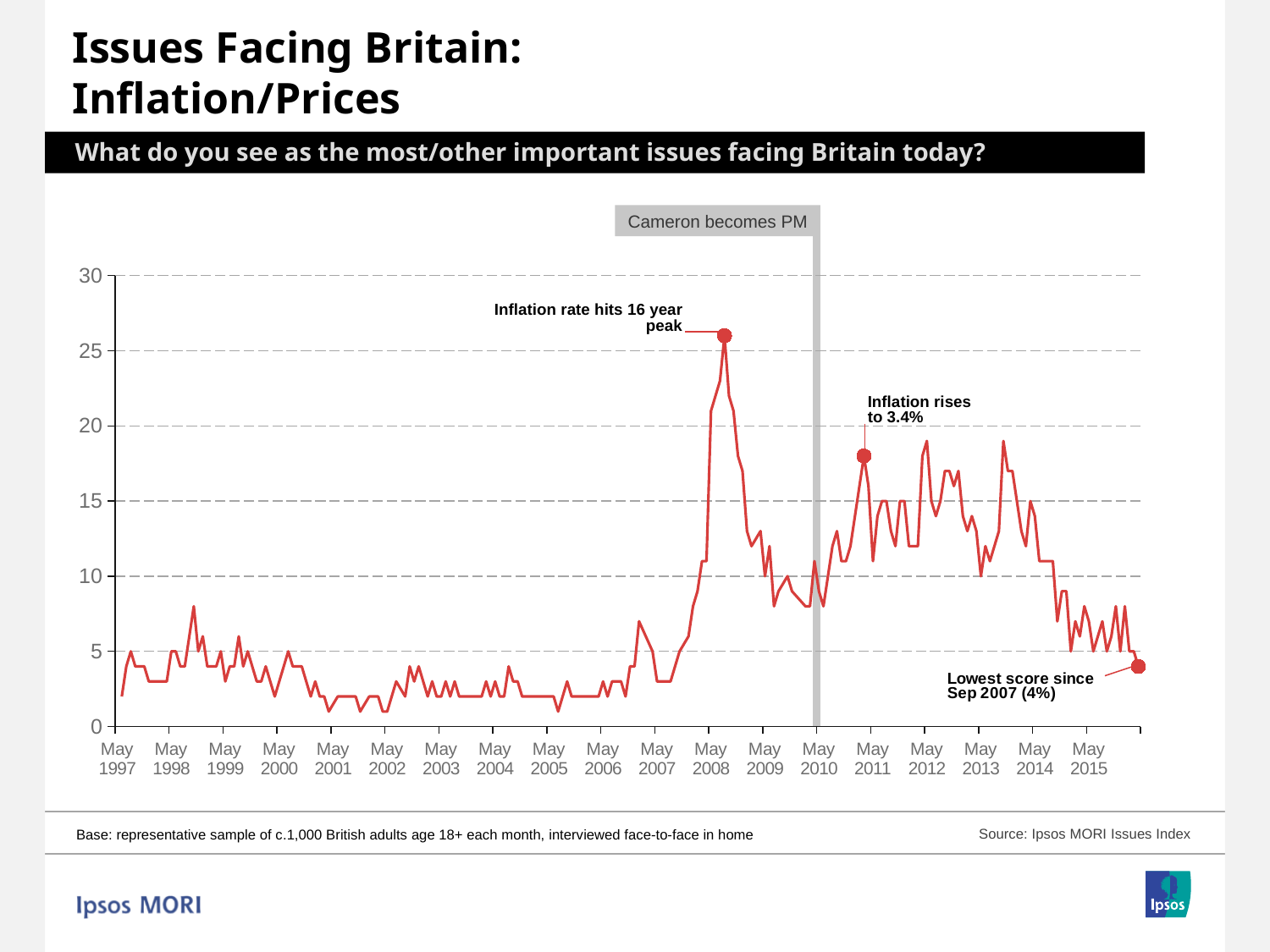
Is the value around May 2001 greater or less than 5? less Does the line rise or fall between May 2014 and May 2015? fall Is the value around May 2010 greater or less than 15? less What value is given for the lowest score since Sep 2007, marked at the end of the line? 4% What kind of chart is shown on the slide? line chart Is the value at the 'Inflation rate hits 16 year peak' point greater or less than 25? greater What event does the vertical grey bar on the chart mark? Cameron becomes PM In which year does the line reach its highest point? 2008 How many 'May' year labels are shown on the x axis? 19 What is the highest value labelled on the y axis? 30 Which is higher: the peak in 2008 or the peak in 2011? the peak in 2008